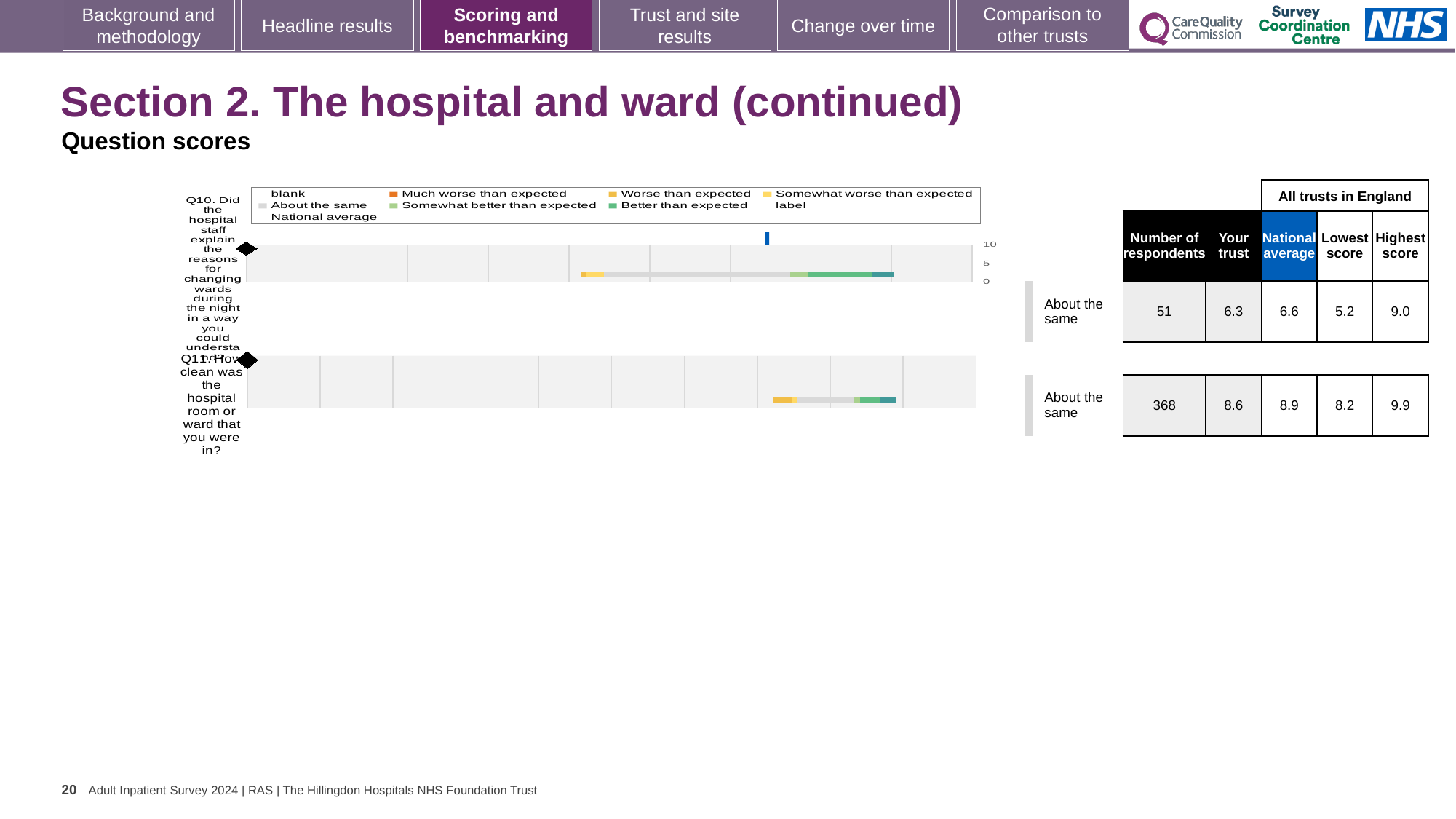
Which question had more respondents, Q10 or Q11? Q11 Which question has the higher 'Your trust' score, Q10 or Q11? Q11 How many survey questions are plotted on the chart? 2 What is the national average score for Q11 (how clean was the hospital room or ward)? 8.9 How many respondents answered Q10? 51 What is the lowest score among all trusts in England for Q11? 8.2 What benchmark category is shown for Q10? About the same What is the 'Your trust' score for Q10 (explaining reasons for changing wards during the night)? 6.3 What is the difference between the highest and lowest scores for Q11? 1.7 What kind of chart is used to show the question scores for Q10 and Q11? bar chart How much higher is the national average than the trust's score for Q10? 0.3